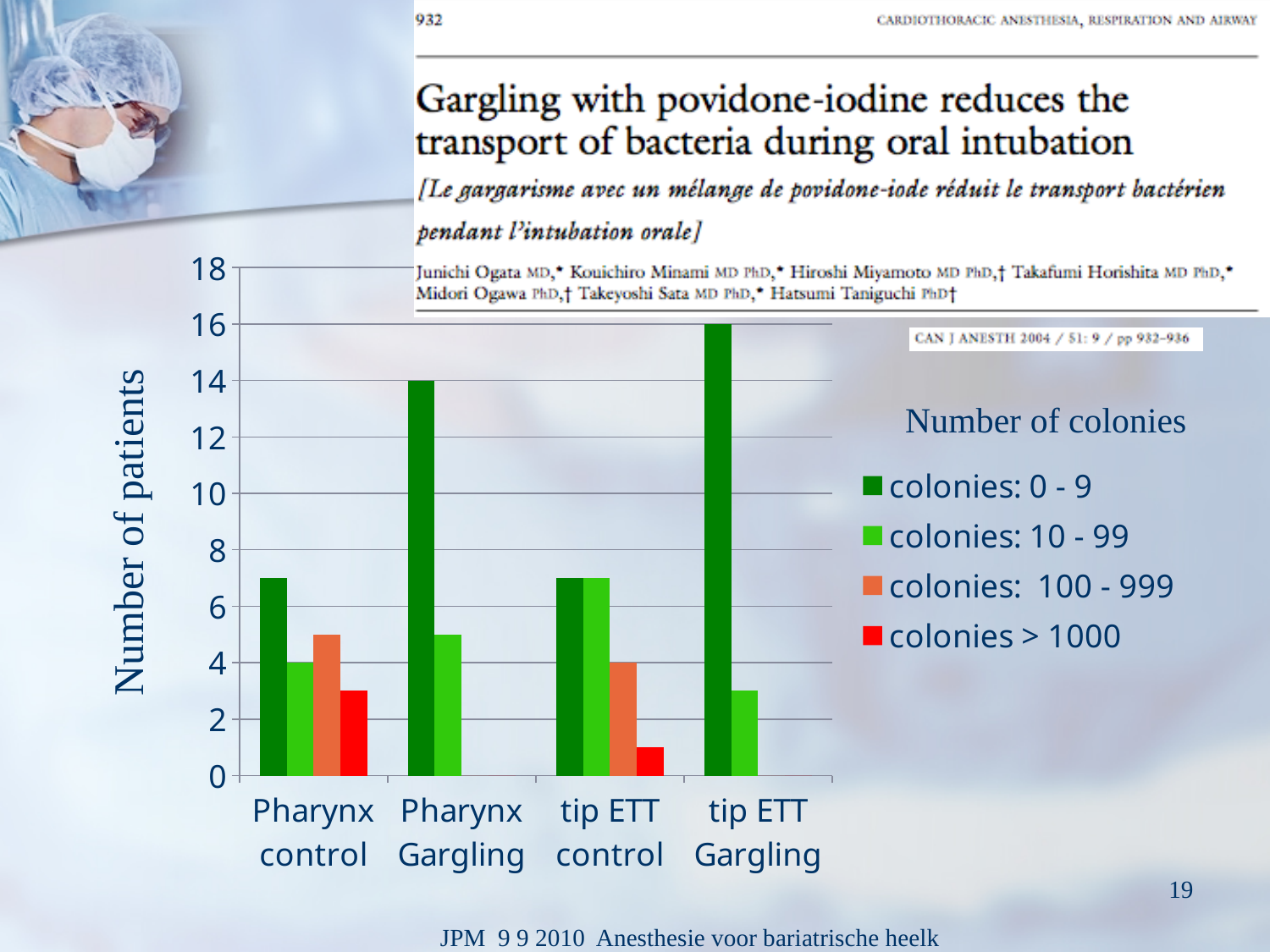
What is the label of the y axis? Number of patients Is the number of patients with colonies 0 - 9 for Pharynx control greater or less than 6? greater Is the number of patients with colonies > 1000 for tip ETT control greater or less than 2? less How many categories are shown on the x axis? 4 What is the number of patients with colonies 0 - 9 for Pharynx Gargling? 14 What kind of chart is shown on the slide? bar chart What is the number of patients with colonies 10 - 99 for Pharynx control? 4 What is the difference between the colonies 0 - 9 values for tip ETT Gargling and Pharynx Gargling? 2 Which is larger: the colonies 0 - 9 bar for Pharynx Gargling or for tip ETT Gargling? tip ETT Gargling What is the number of patients with colonies 0 - 9 for tip ETT Gargling? 16 Which category has the highest bar for colonies 0 - 9? tip ETT Gargling How many series does the legend list? 4